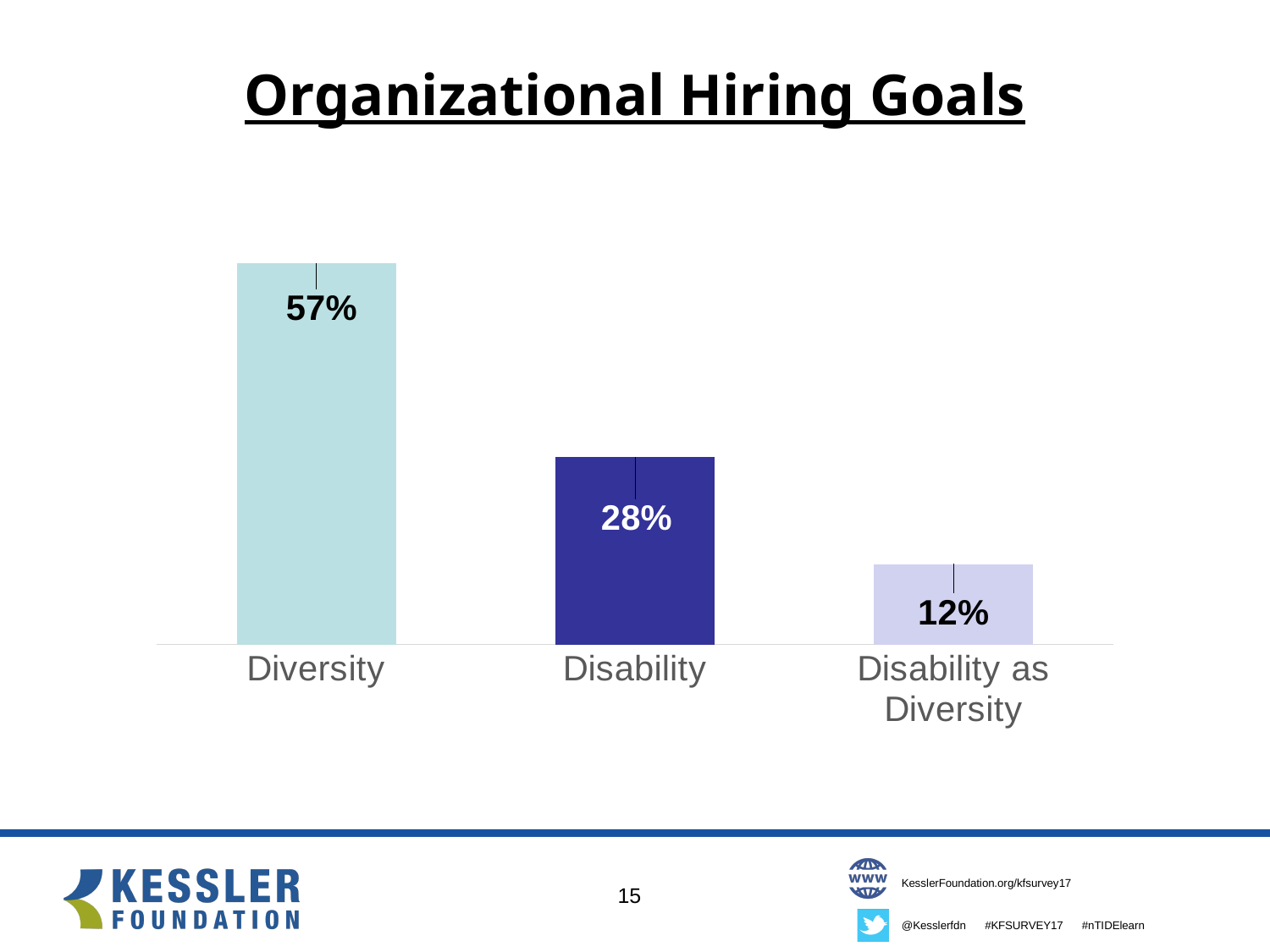
Do the values rise or fall from left to right across the categories? Fall What is the value for Disability as Diversity? 12% What is the title of the slide containing the chart? Organizational Hiring Goals What is the value for Diversity? 57% What kind of chart is shown on the slide? Bar chart Which category has the highest value? Diversity What is the difference between the values for Diversity and Disability? 29% Which category has the lowest value? Disability as Diversity How many categories are shown in the chart? 3 What is the difference between the values for Disability and Disability as Diversity? 16% What is the value for Disability? 28% Which is larger, the value for Disability or the value for Disability as Diversity? Disability